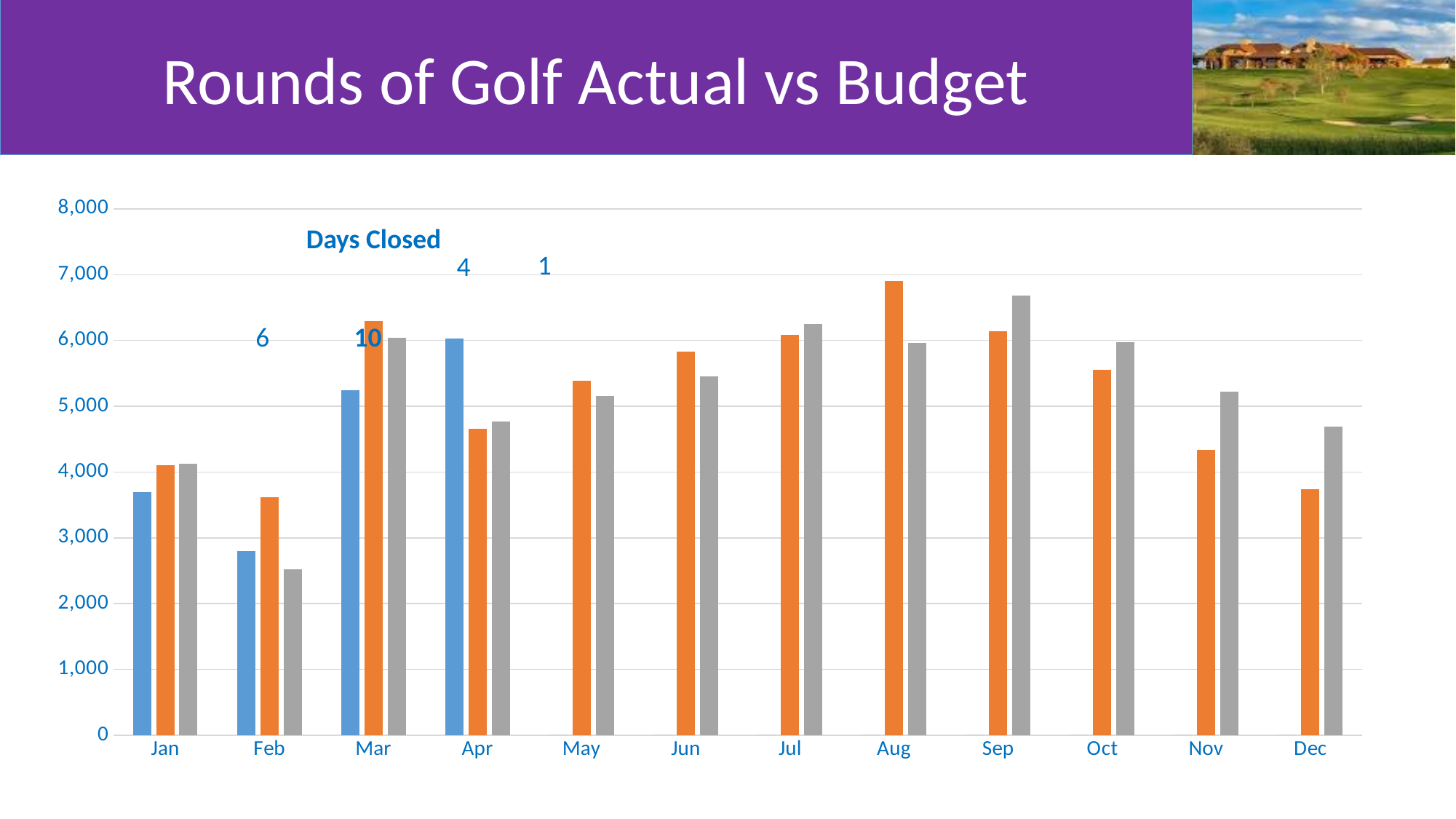
In which month is the orange bar the highest? Aug What is the title of the slide? Rounds of Golf Actual vs Budget Is the value of the blue bar for Jan greater or less than 4,000? less In Sep, which bar is larger, the orange bar or the gray bar? gray Is the value of the orange bar for Dec greater or less than 4,000? less In which month is the gray bar the lowest? Feb Is the value of the orange bar for Aug greater or less than 6,000? greater In Feb, which bar is larger, the orange bar or the gray bar? orange In which month is the gray bar the highest? Sep How many months are shown on the x axis of the chart? 12 What kind of chart is shown on the slide? bar chart